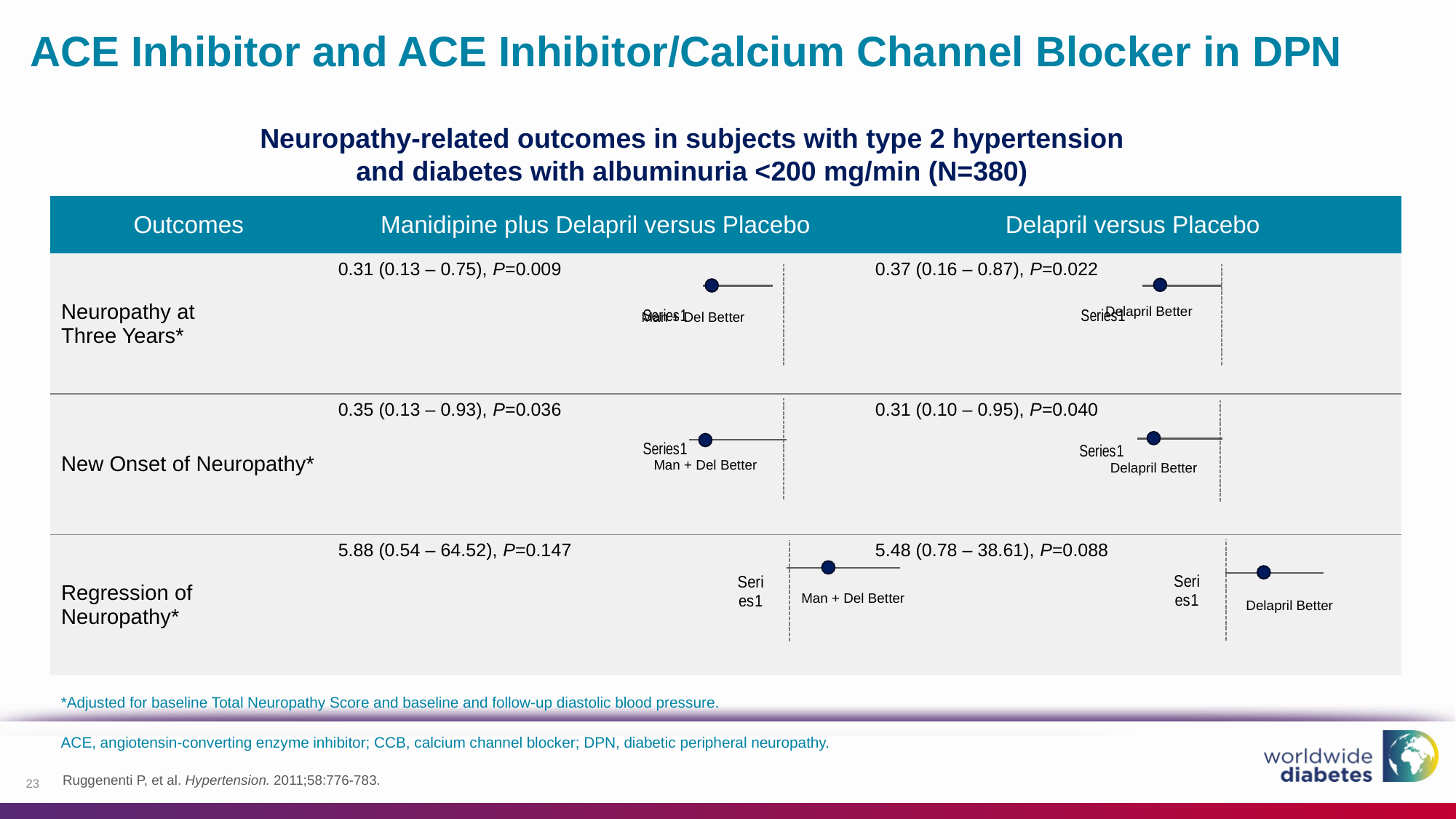
In the Manidipine plus Delapril versus Placebo column, what is the P value for Regression of Neuropathy? P=0.147 In the Manidipine plus Delapril versus Placebo column, what is the P value for New Onset of Neuropathy? P=0.036 In the Delapril versus Placebo column, what is the odds ratio for Neuropathy at Three Years? 0.37 (0.16 – 0.87) Across the three outcomes in the Delapril versus Placebo column, which outcome has the highest point estimate? Regression of Neuropathy What label appears beneath the point in the Delapril versus Placebo chart for New Onset of Neuropathy? Delapril Better Across the three outcomes in the Manidipine plus Delapril versus Placebo column, which outcome has the lowest point estimate? Neuropathy at Three Years What label appears beneath the point in the Manidipine plus Delapril versus Placebo chart for Regression of Neuropathy? Man + Del Better For New Onset of Neuropathy, which comparison has the lower point estimate: Manidipine plus Delapril versus Placebo or Delapril versus Placebo? Delapril versus Placebo For Regression of Neuropathy, which comparison has the larger point estimate: Manidipine plus Delapril versus Placebo or Delapril versus Placebo? Manidipine plus Delapril versus Placebo In the Delapril versus Placebo column, what is the odds ratio for Regression of Neuropathy? 5.48 (0.78 – 38.61) How many small forest-plot charts are shown in the table on the slide? 6 In the Manidipine plus Delapril versus Placebo column, what is the odds ratio for Neuropathy at Three Years? 0.31 (0.13 – 0.75)